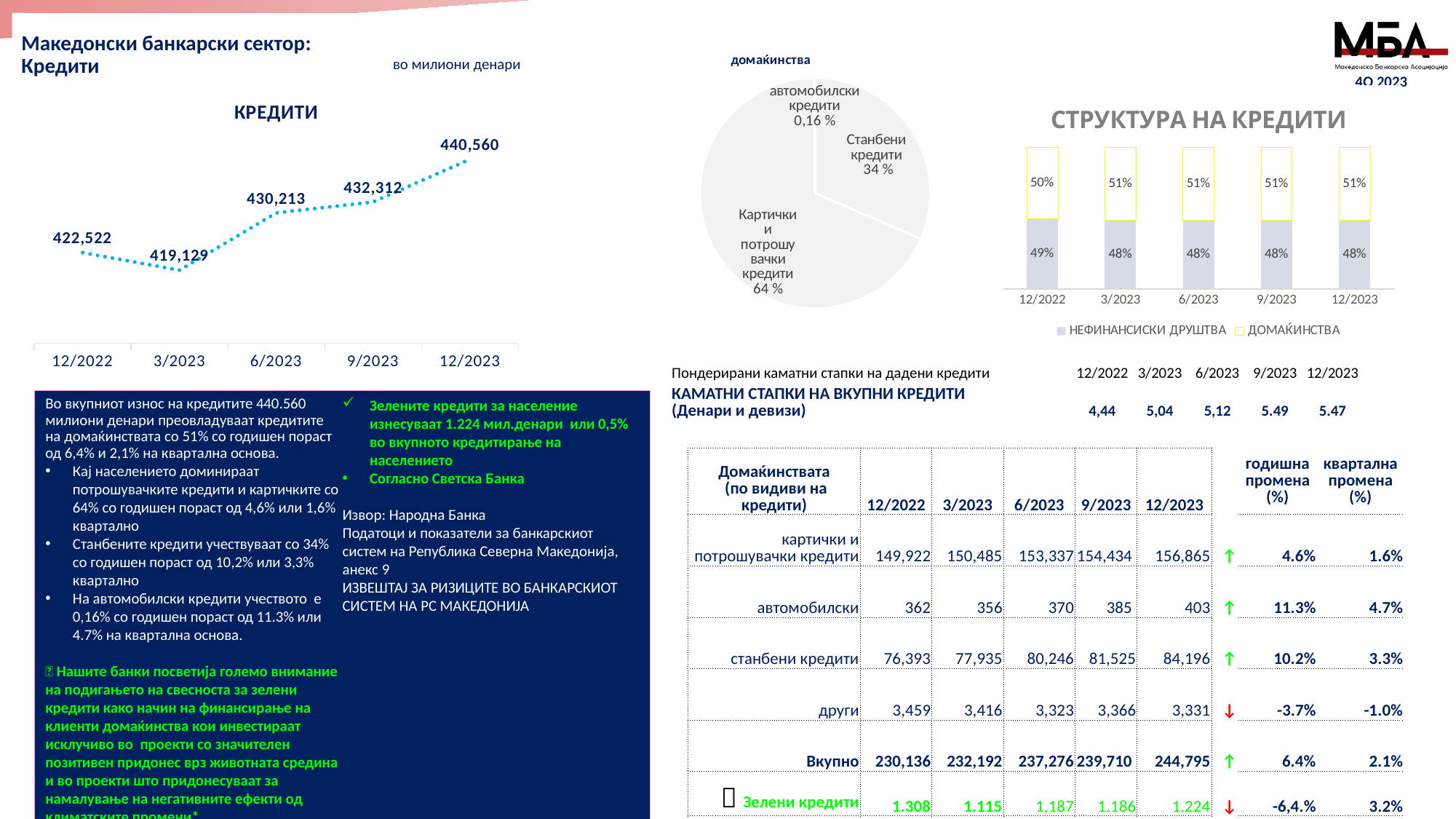
In the КРЕДИТИ line chart, what is the value for 3/2023? 419,129 In the домаќинства pie chart, what share do автомобилски кредити have? 0,16 % In the КРЕДИТИ line chart, do the values rise or fall from 3/2023 to 12/2023? rise How many series does the legend of the СТРУКТУРА НА КРЕДИТИ chart list? 2 In the КРЕДИТИ line chart, what is the value for 12/2023? 440,560 In the КРЕДИТИ line chart, what is the difference between the values for 12/2023 and 12/2022? 18,038 In the домаќинства pie chart, what share do Станбени кредити have? 34 % In the домаќинства pie chart, which slice is the largest? Картички и потрошувачки кредити In the КРЕДИТИ line chart, how many periods are plotted on the x axis? 5 In the КРЕДИТИ line chart, which period has the lowest value? 3/2023 In the СТРУКТУРА НА КРЕДИТИ chart, what is the value for НЕФИНАНСИСКИ ДРУШТВА in 12/2022? 49% In the КРЕДИТИ line chart, which period has the highest value? 12/2023